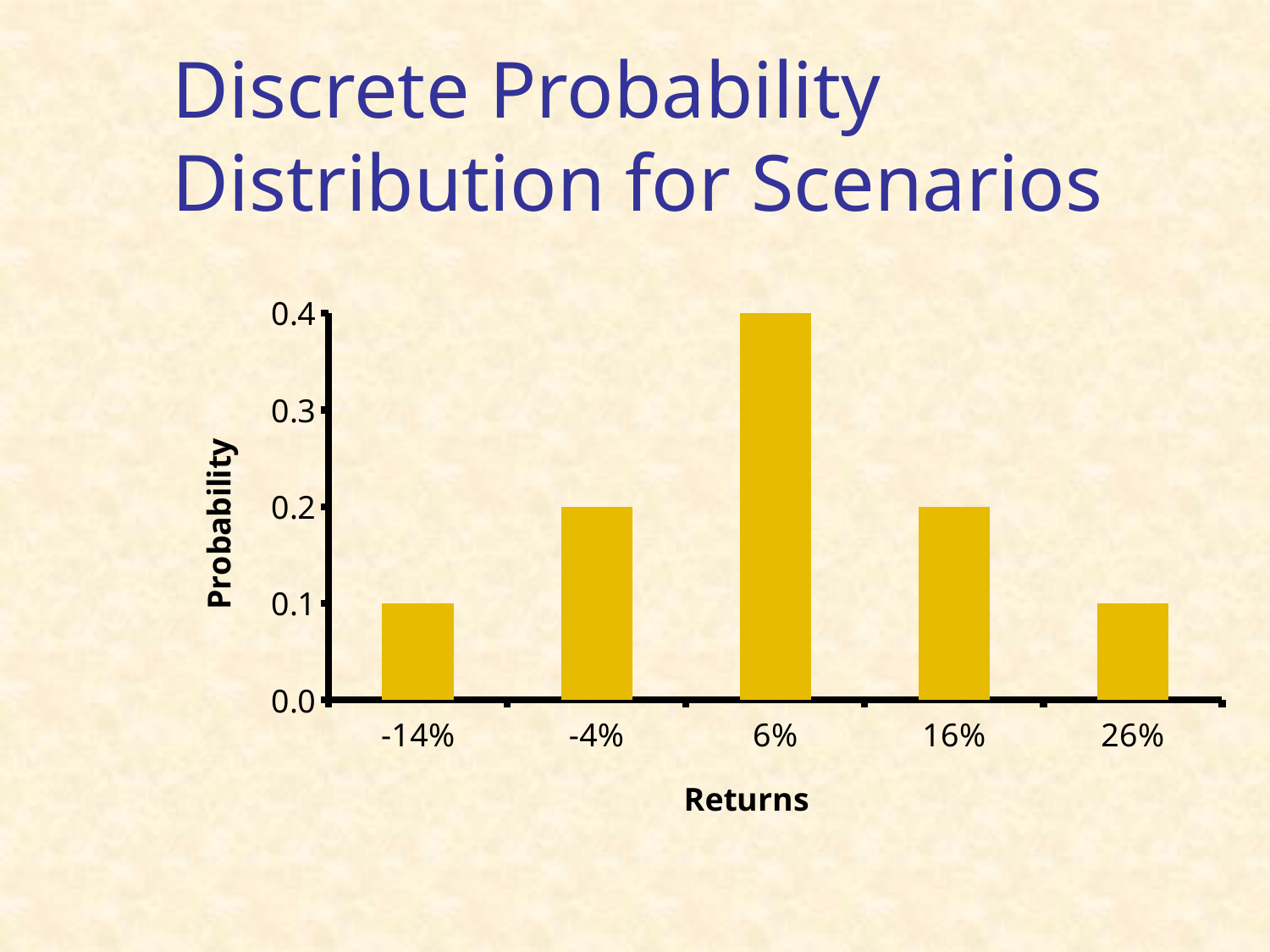
What type of chart is shown on the slide? bar chart Do the probabilities rise or fall from the 6% return to the 26% return? fall What is the probability for a return of 16%? 0.2 What is the probability for a return of -14%? 0.1 Which has the larger probability, a return of -4% or a return of 26%? -4% Is the probability for a return of 6% greater or less than 0.3? greater What is the probability for a return of 6%? 0.4 Which return has the highest probability? 6% What is the label of the y axis? Probability How many return categories are plotted on the x axis? 5 What is the difference in probability between the 6% return and the -4% return? 0.2 What is the label of the x axis? Returns